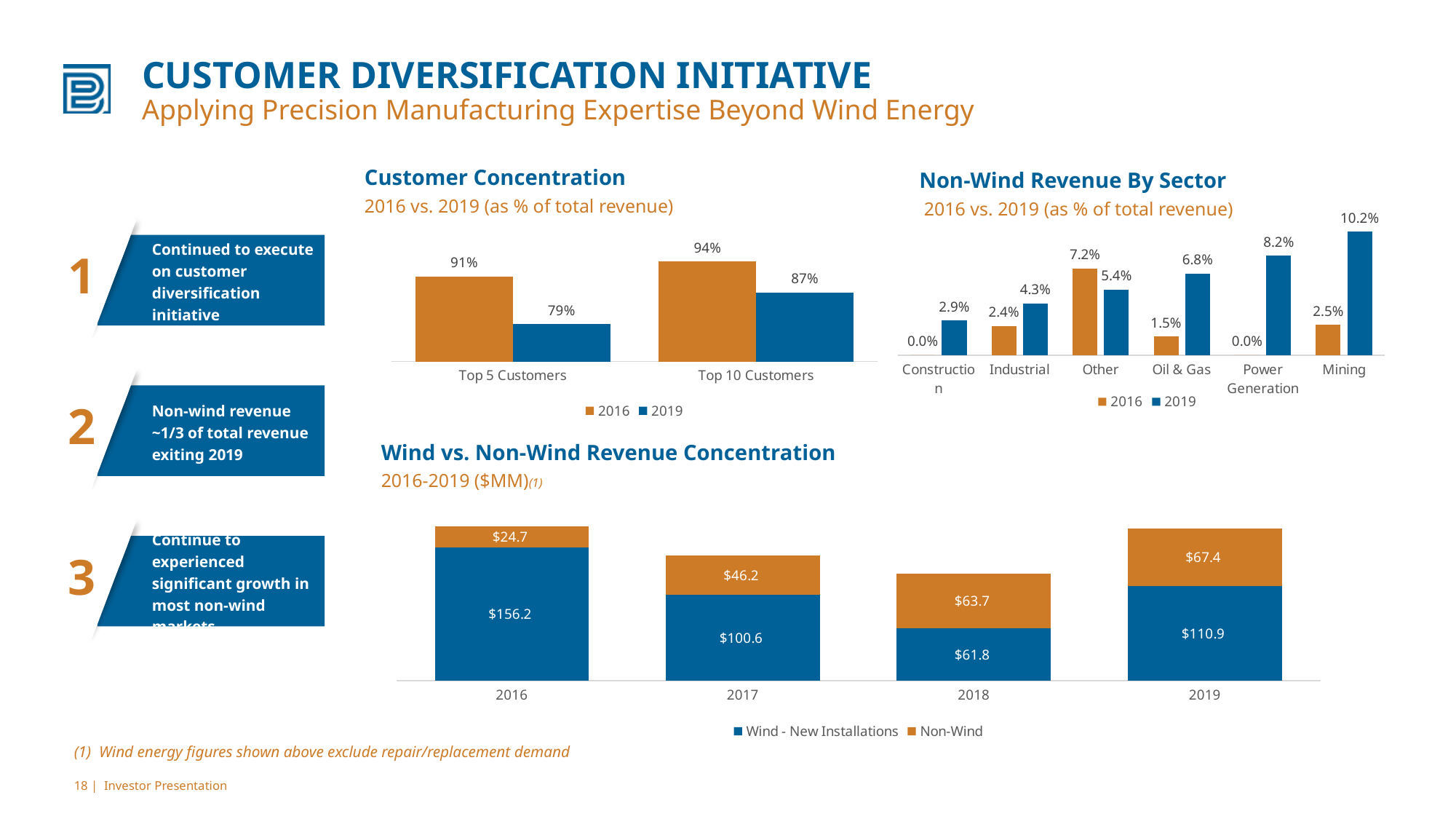
In the Wind vs. Non-Wind Revenue Concentration chart, what is the total of the stacked bar for 2019? $178.3 In the Customer Concentration chart, what was the 2019 value for Top 5 Customers? 79% In the Customer Concentration chart, what is the difference between the 2016 and 2019 values for Top 10 Customers? 7% In the Non-Wind Revenue By Sector chart, how many sectors are shown on the x axis? 6 In the Non-Wind Revenue By Sector chart, which sector has the highest 2019 value? Mining In the Non-Wind Revenue By Sector chart, is the 2019 value for Power Generation larger or smaller than the 2019 value for Oil & Gas? larger In the Non-Wind Revenue By Sector chart, what was the 2016 value for Oil & Gas? 1.5% What kind of chart is the Wind vs. Non-Wind Revenue Concentration chart? Stacked bar chart In the Customer Concentration chart, how many series does the legend list? 2 In the Wind vs. Non-Wind Revenue Concentration chart, which year has the lowest Wind - New Installations value? 2018 In the Non-Wind Revenue By Sector chart, which sector has the highest 2016 value? Other In the Wind vs. Non-Wind Revenue Concentration chart, what was the Non-Wind value in 2018? $63.7